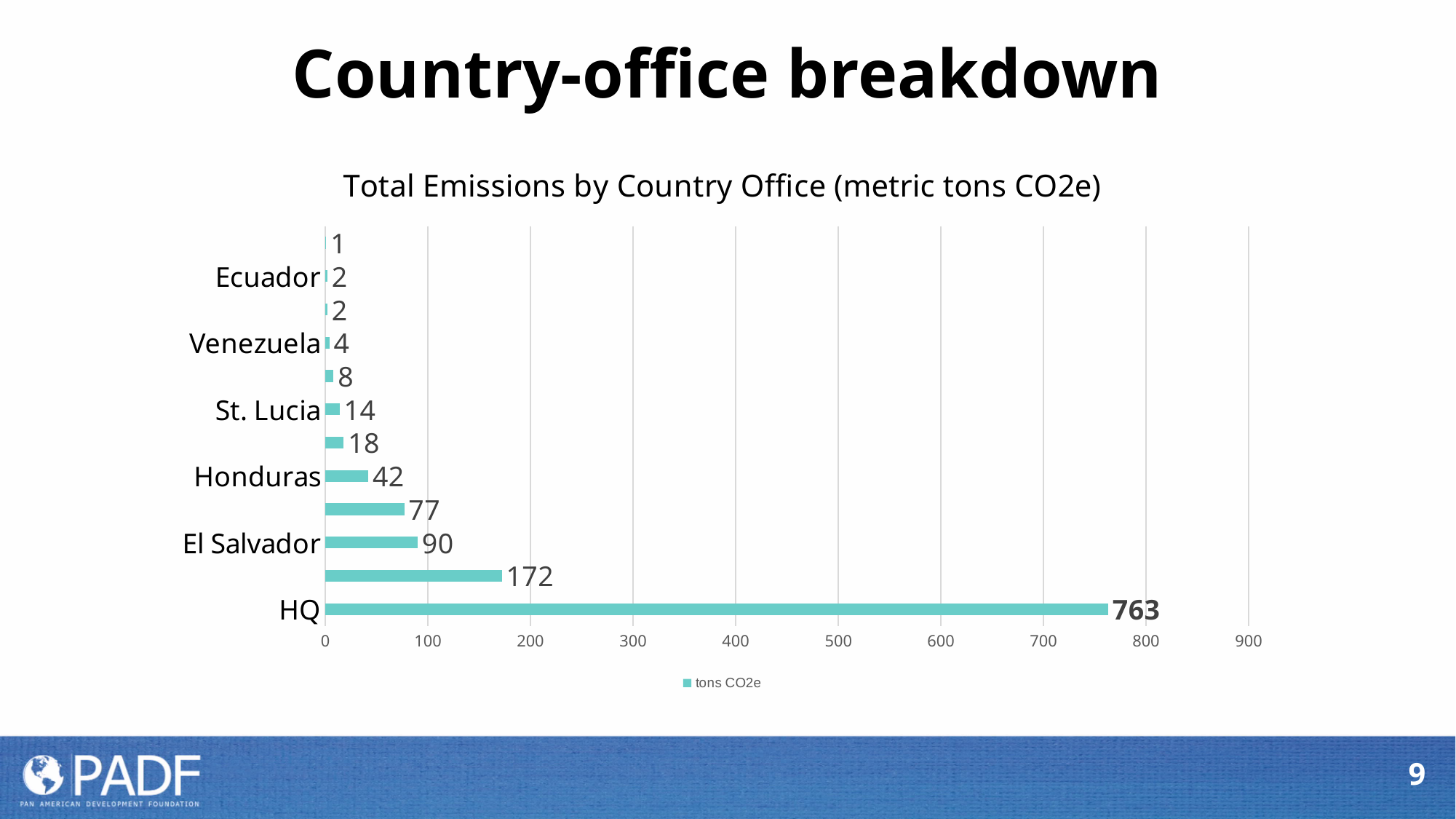
What is the value for El Salvador? 90 Is the value for HQ greater or less than 700? greater What is the value for Honduras? 42 What is the value for Venezuela? 4 Which country office has the highest emissions? HQ What is the title of the chart? Total Emissions by Country Office (metric tons CO2e) How many bars are plotted in the chart? 12 Which is larger, the value for El Salvador or the value for Honduras? El Salvador What is the value for St. Lucia? 14 What is the value for HQ? 763 What kind of chart is shown? bar chart What is the difference between the values for HQ and El Salvador? 673